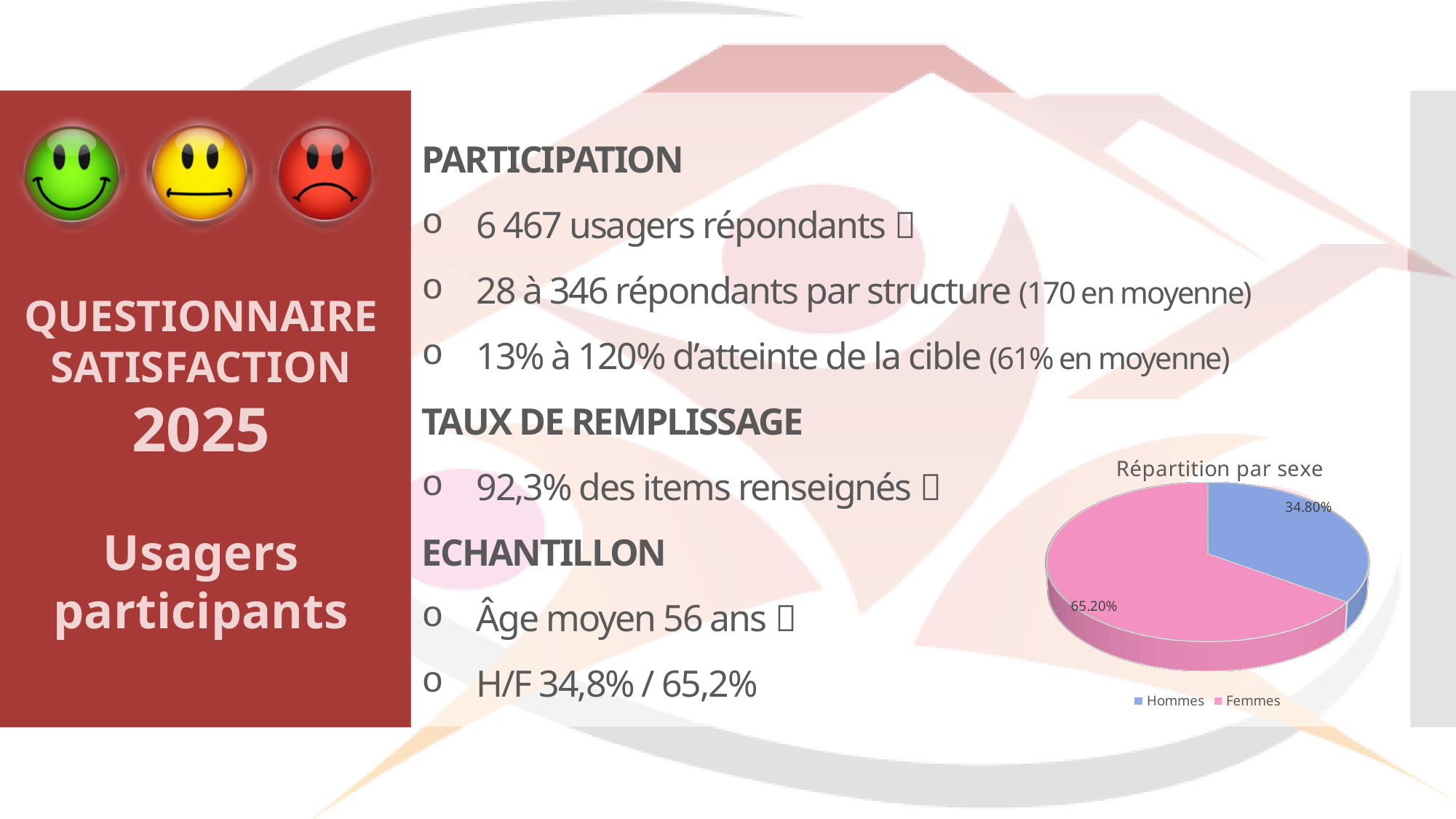
What share of the pie chart is Femmes? 65.20% Which colour represents Femmes in the pie chart? pink What share of the pie chart is Hommes? 34.80% What type of chart is shown on the slide? pie chart Which category has the largest slice in the pie chart? Femmes Which is larger in the pie chart, Hommes or Femmes? Femmes How many slices does the pie chart have? 2 What is the title of the pie chart? Répartition par sexe What is the difference in percentage points between the Femmes and Hommes slices? 30.40% How many entries does the legend of the pie chart list? 2 Which category has the smallest slice in the pie chart? Hommes